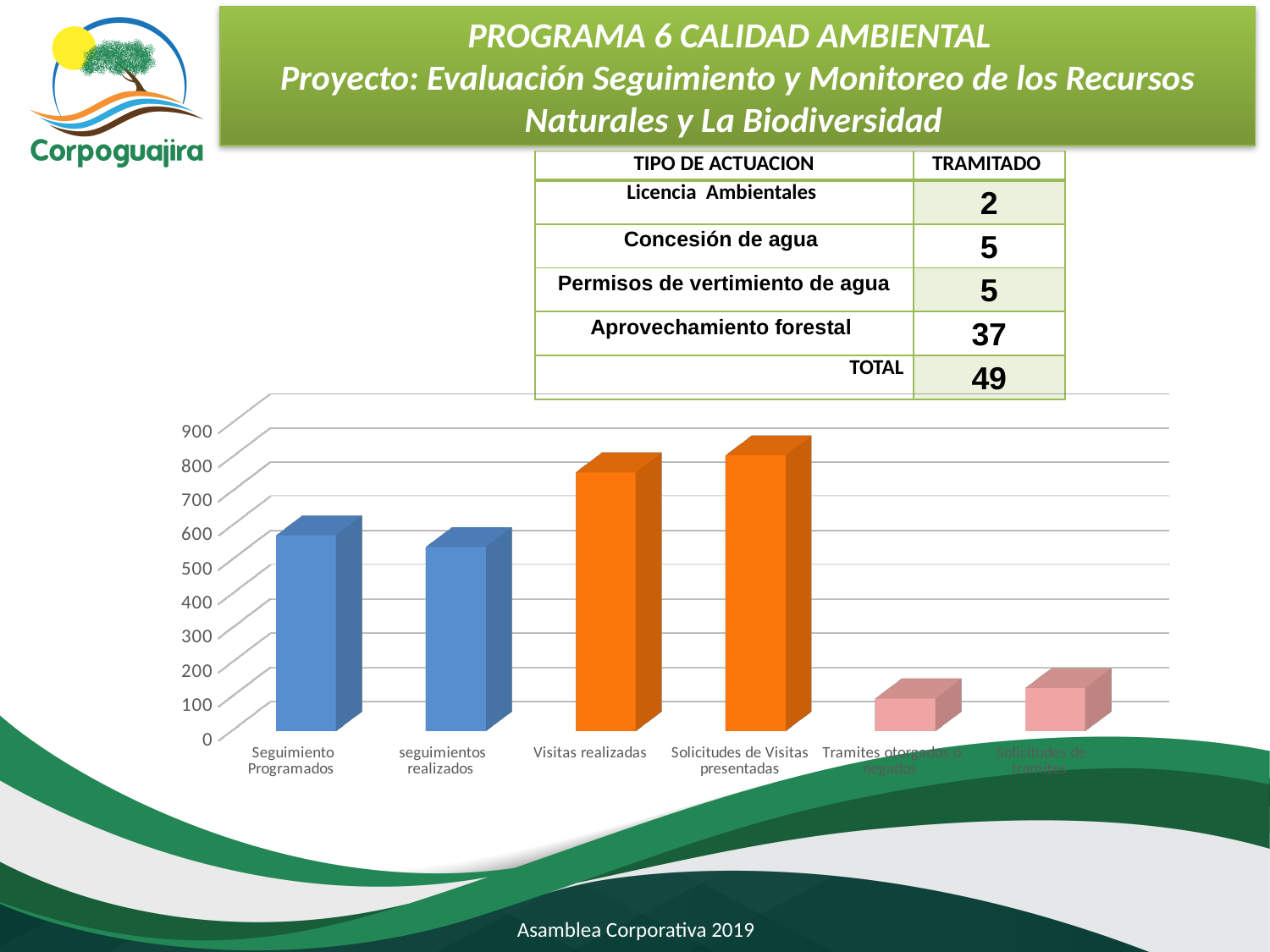
What kind of chart is shown on the slide? bar chart Is the value for Solicitudes de tramites greater or less than 300? less How many categories are plotted on the bar chart? 6 Is the value for Solicitudes de Visitas presentadas greater or less than 600? greater Is the value for Seguimiento Programados greater or less than 500? greater Which is larger, the bar for Seguimiento Programados or the bar for seguimientos realizados? Seguimiento Programados Which category has the lowest bar in the chart? Tramites otorgados o negados What colour are the bars for Visitas realizadas and Solicitudes de Visitas presentadas? orange Which is larger, the bar for Visitas realizadas or the bar for Seguimiento Programados? Visitas realizadas Which category has the highest bar in the chart? Solicitudes de Visitas presentadas